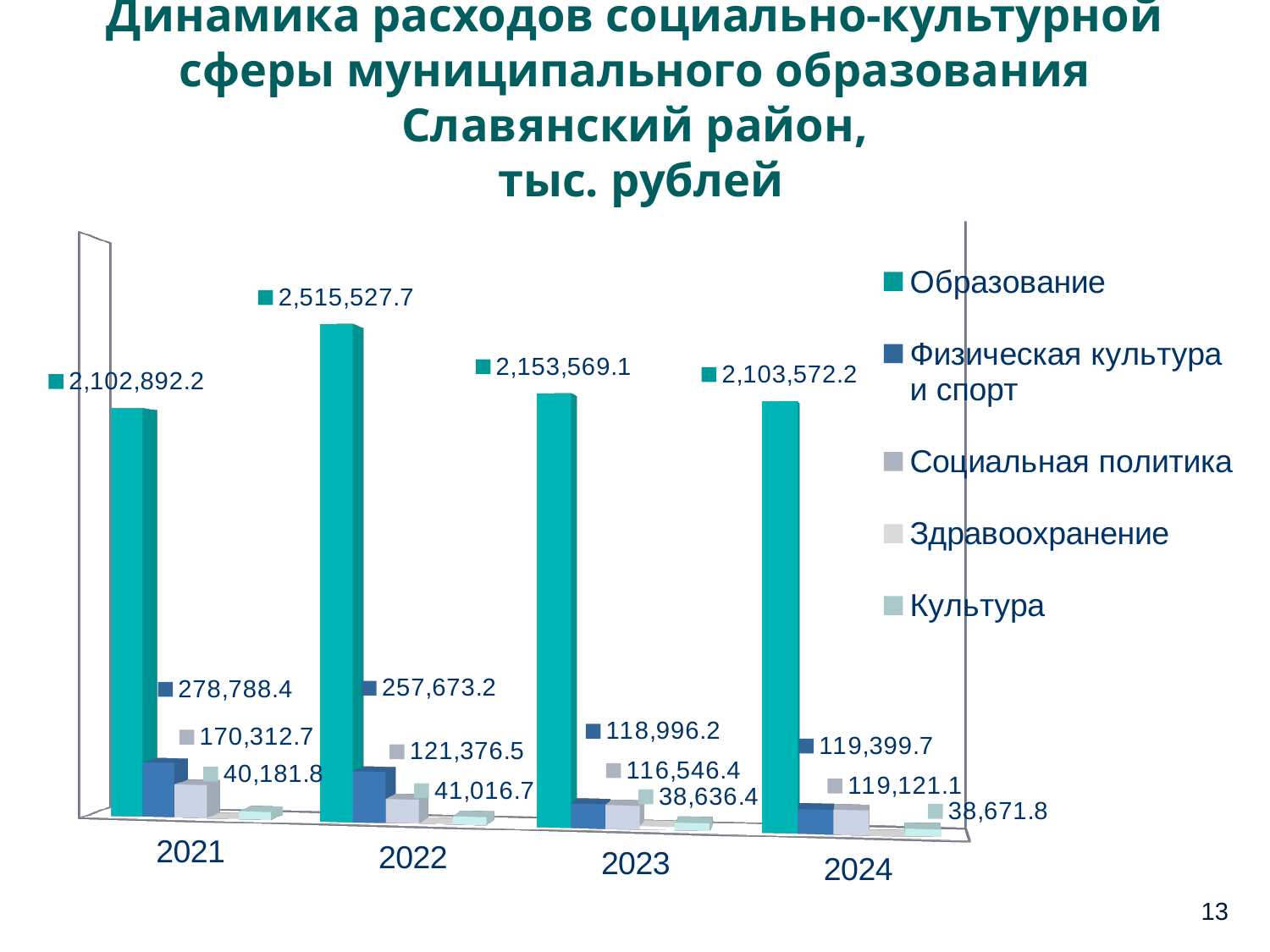
What is the difference between the Образование values for 2022 and 2021? 412,635.5 What is the value for Образование in 2022? 2,515,527.7 How many years are shown on the x axis? 4 In which year is the value for Образование the highest? 2022 How many series does the legend list? 5 Which is larger in 2021: Физическая культура и спорт or Социальная политика? Физическая культура и спорт In which year is the value for Социальная политика the lowest? 2023 What is the value for Физическая культура и спорт in 2021? 278,788.4 Does the value for Образование rise or fall from 2022 to 2023? Fall What is the value for Культура in 2024? 38,671.8 What kind of chart is shown on the slide? Bar chart What is the value for Социальная политика in 2023? 116,546.4